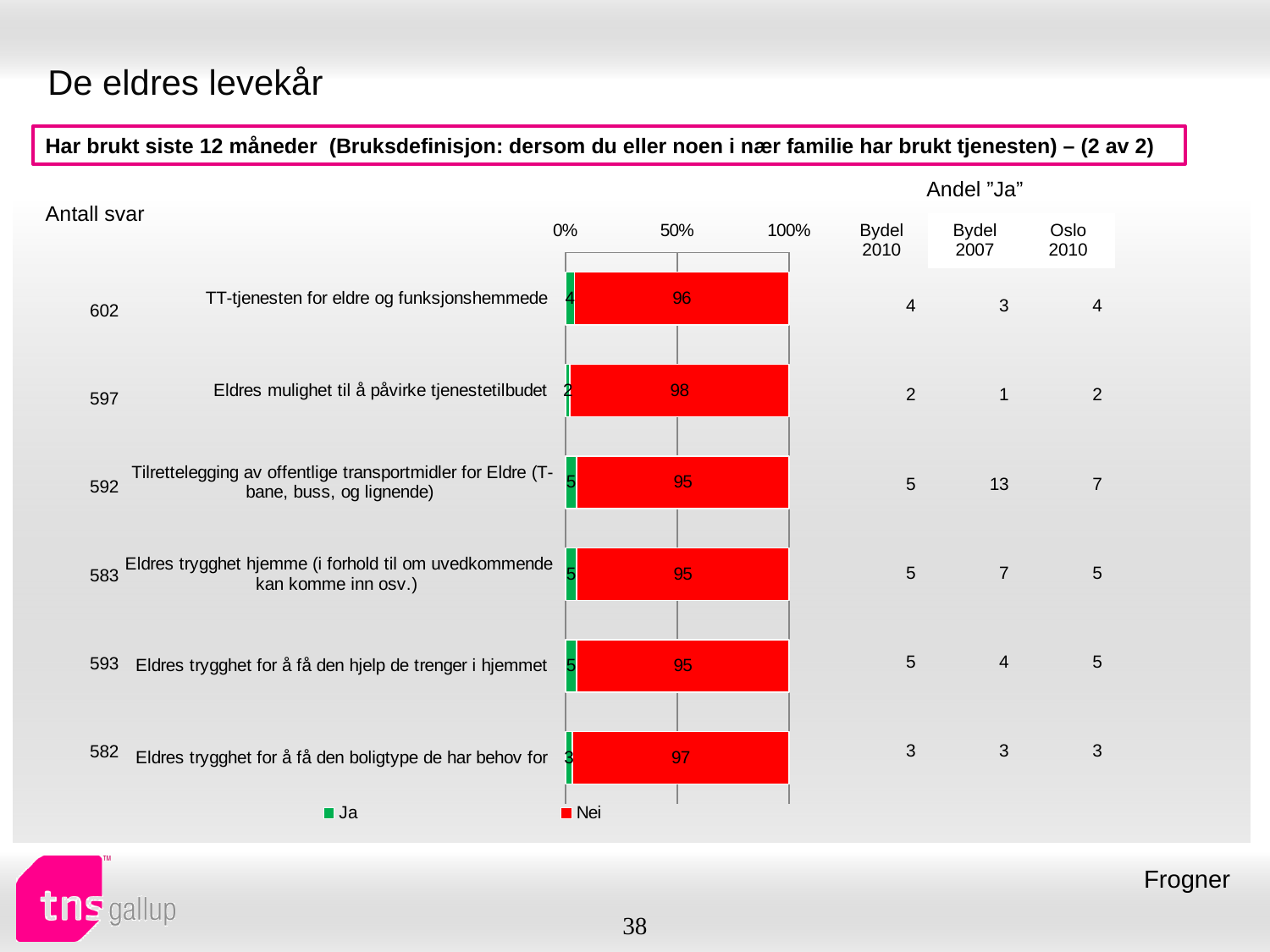
What is the 'Nei' value for 'Eldres trygghet for å få den boligtype de har behov for'? 97 What kind of chart is shown on the slide? bar chart What is the 'Nei' value for 'Eldres mulighet til å påvirke tjenestetilbudet'? 98 Which colour represents the 'Nei' series in the chart? red What are the two series named in the chart legend? Ja and Nei What is the difference between the 'Nei' values for 'Eldres mulighet til å påvirke tjenestetilbudet' and 'TT-tjenesten for eldre og funksjonshemmede'? 2 How many categories are plotted in the chart? 6 Is the 'Nei' value for 'Tilrettelegging av offentlige transportmidler for Eldre (T-bane, buss, og lignende)' greater or less than 50%? greater Which category has the highest 'Nei' value? Eldres mulighet til å påvirke tjenestetilbudet Which has a larger 'Nei' value: 'Eldres trygghet for å få den boligtype de har behov for' or 'Eldres trygghet for å få den hjelp de trenger i hjemmet'? Eldres trygghet for å få den boligtype de har behov for What is the 'Nei' value for 'TT-tjenesten for eldre og funksjonshemmede'? 96 How many series does the chart legend list? 2